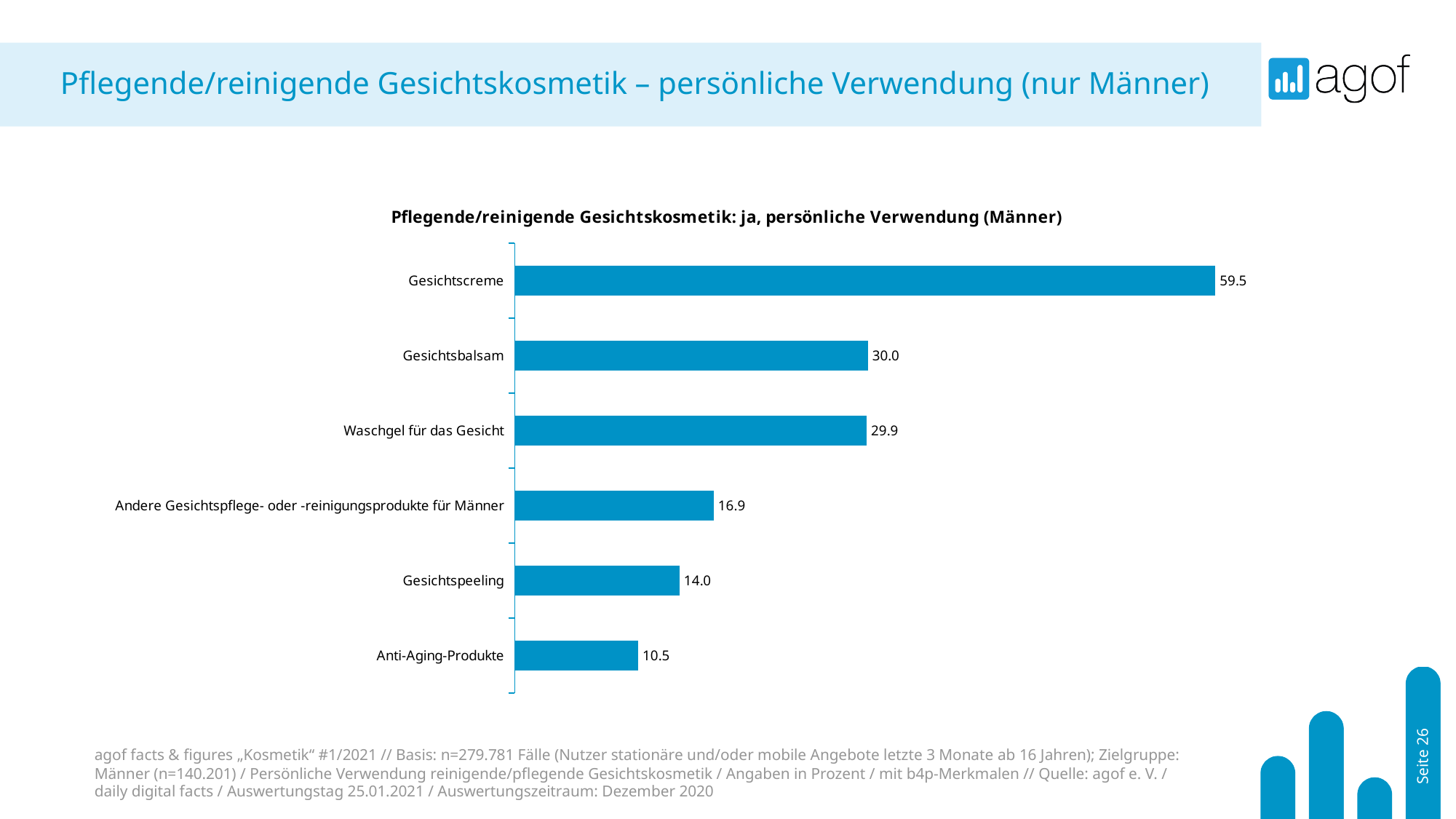
What is the value for Anti-Aging-Produkte? 10.5 What is the title of the chart? Pflegende/reinigende Gesichtskosmetik: ja, persönliche Verwendung (Männer) What is the value for Gesichtspeeling? 14.0 What is the value for Waschgel für das Gesicht? 29.9 What kind of chart is shown on the slide? Bar chart Which category has the lowest value? Anti-Aging-Produkte Which is larger, the value for Gesichtspeeling or the value for Anti-Aging-Produkte? Gesichtspeeling What is the value for Gesichtscreme? 59.5 Which category has the highest value? Gesichtscreme What is the difference between the values for Andere Gesichtspflege- oder -reinigungsprodukte für Männer and Gesichtspeeling? 2.9 What is the difference between the values for Gesichtscreme and Gesichtsbalsam? 29.5 How many categories are shown in the chart? 6